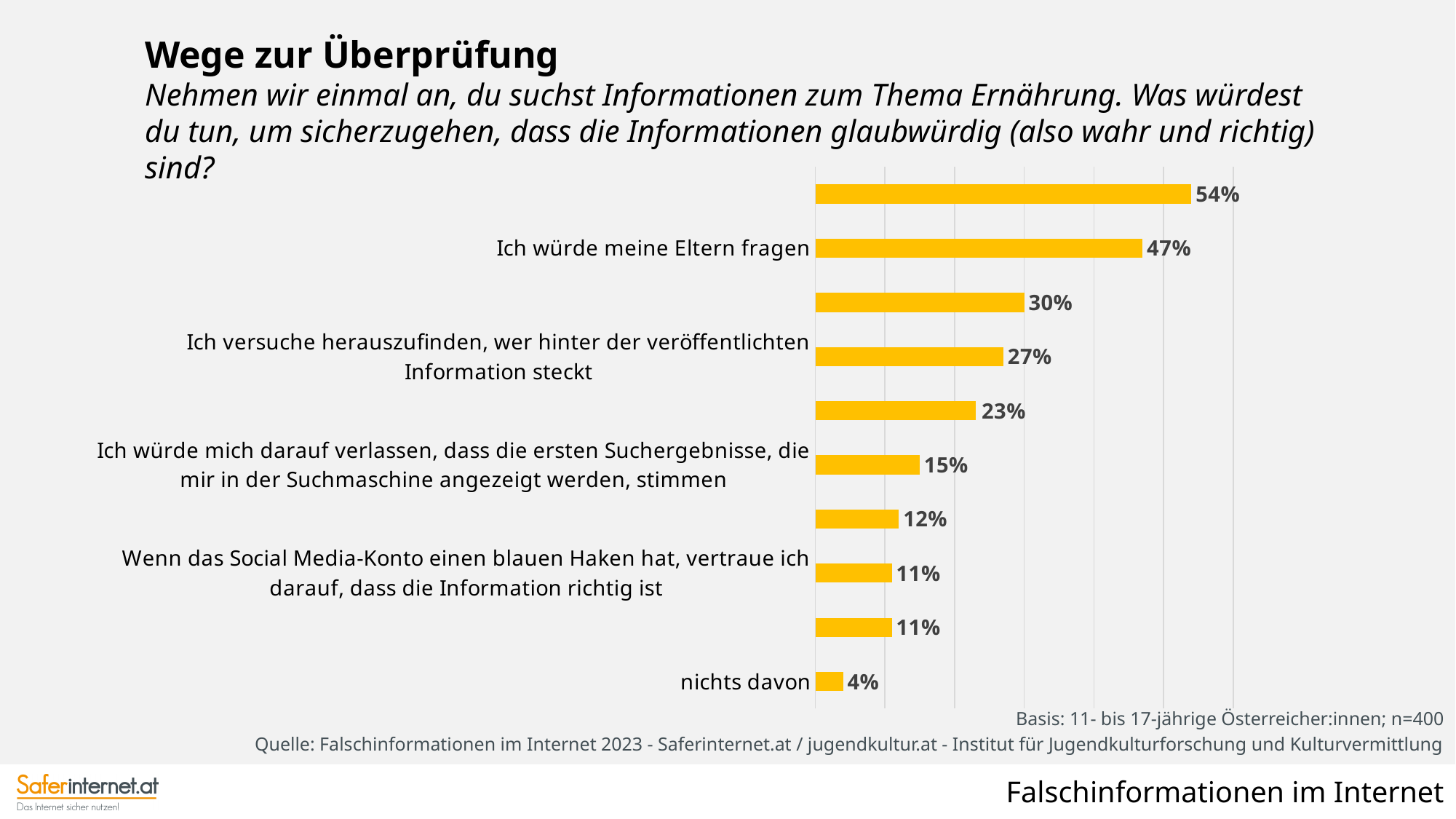
Which is larger: the value for "Ich würde meine Eltern fragen" or the value for "Ich versuche herauszufinden, wer hinter der veröffentlichten Information steckt"? Ich würde meine Eltern fragen What percentage of respondents said "Ich würde meine Eltern fragen"? 47% What value is shown for "Ich versuche herauszufinden, wer hinter der veröffentlichten Information steckt"? 27% What percentage is shown for "Ich würde mich darauf verlassen, dass die ersten Suchergebnisse, die mir in der Suchmaschine angezeigt werden, stimmen"? 15% Which labelled category has the lowest value in the chart? nichts davon Do the bar values increase or decrease from the top of the chart to the bottom? Decrease What value is shown for the bar labelled "Wenn das Social Media-Konto einen blauen Haken hat, vertraue ich darauf, dass die Information richtig ist"? 11% What is the highest value shown on any bar in the chart? 54% What is the difference between the value for "Ich würde meine Eltern fragen" and the value for "nichts davon"? 43 percentage points What percentage is shown for "nichts davon"? 4% What type of chart is shown on the slide? Bar chart How many bars are shown in the chart? 10